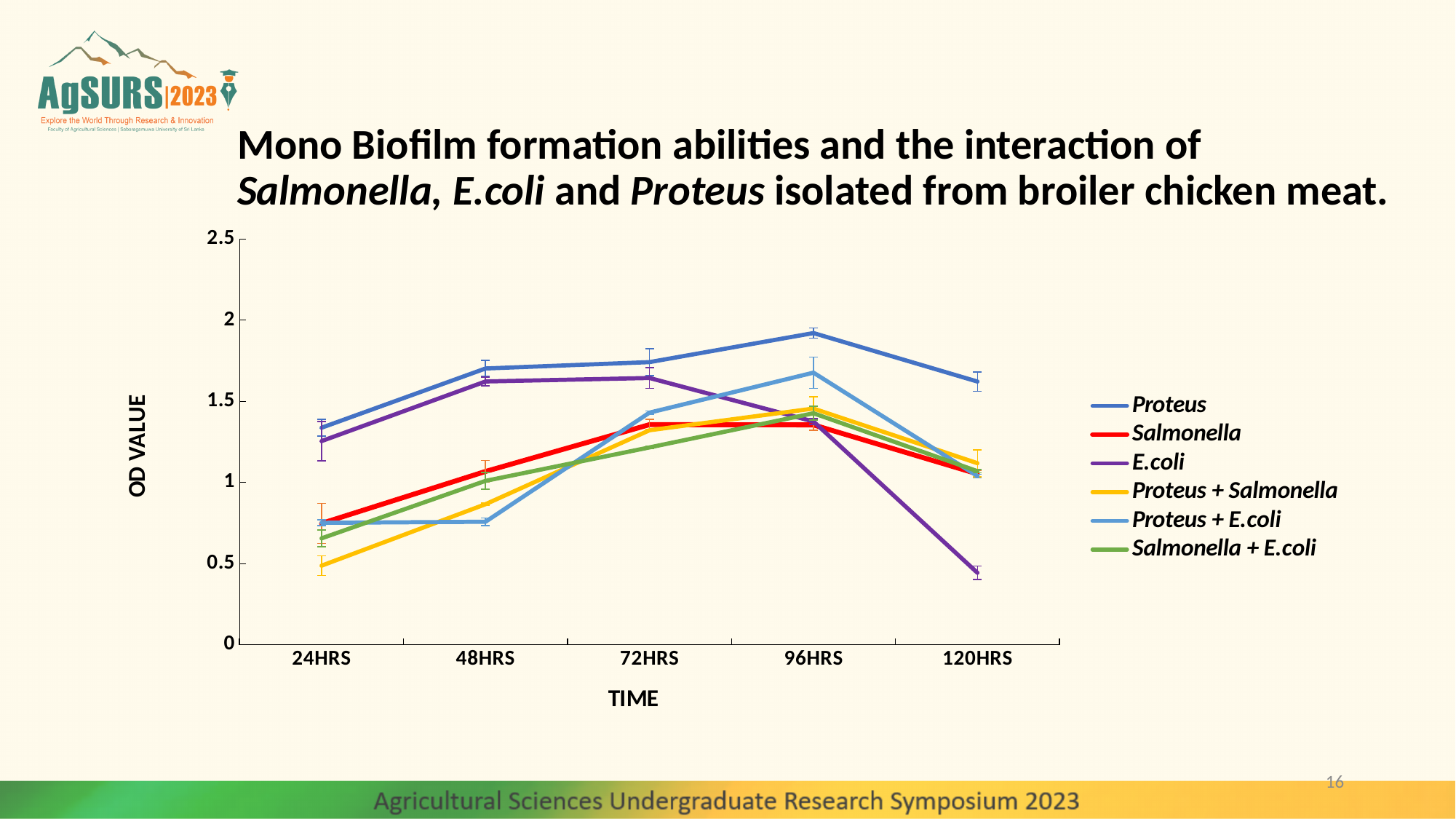
What kind of chart is shown on the slide? line chart Which series has the lowest OD value at 24HRS? Proteus + Salmonella What is the label on the y axis? OD VALUE Is the OD value for E.coli at 120HRS greater or less than 1? less Which series has the lowest OD value at 120HRS? E.coli How many time points are plotted along the x axis? 5 Does the OD value for E.coli rise or fall from 72HRS to 120HRS? fall Is the OD value for Proteus at 96HRS greater or less than 1.5? greater How many series does the legend list? 6 Which series has the highest OD value at 96HRS? Proteus At which time point does Proteus reach its highest OD value? 96HRS Which is larger at 48HRS, the OD value for Proteus or for Salmonella? Proteus